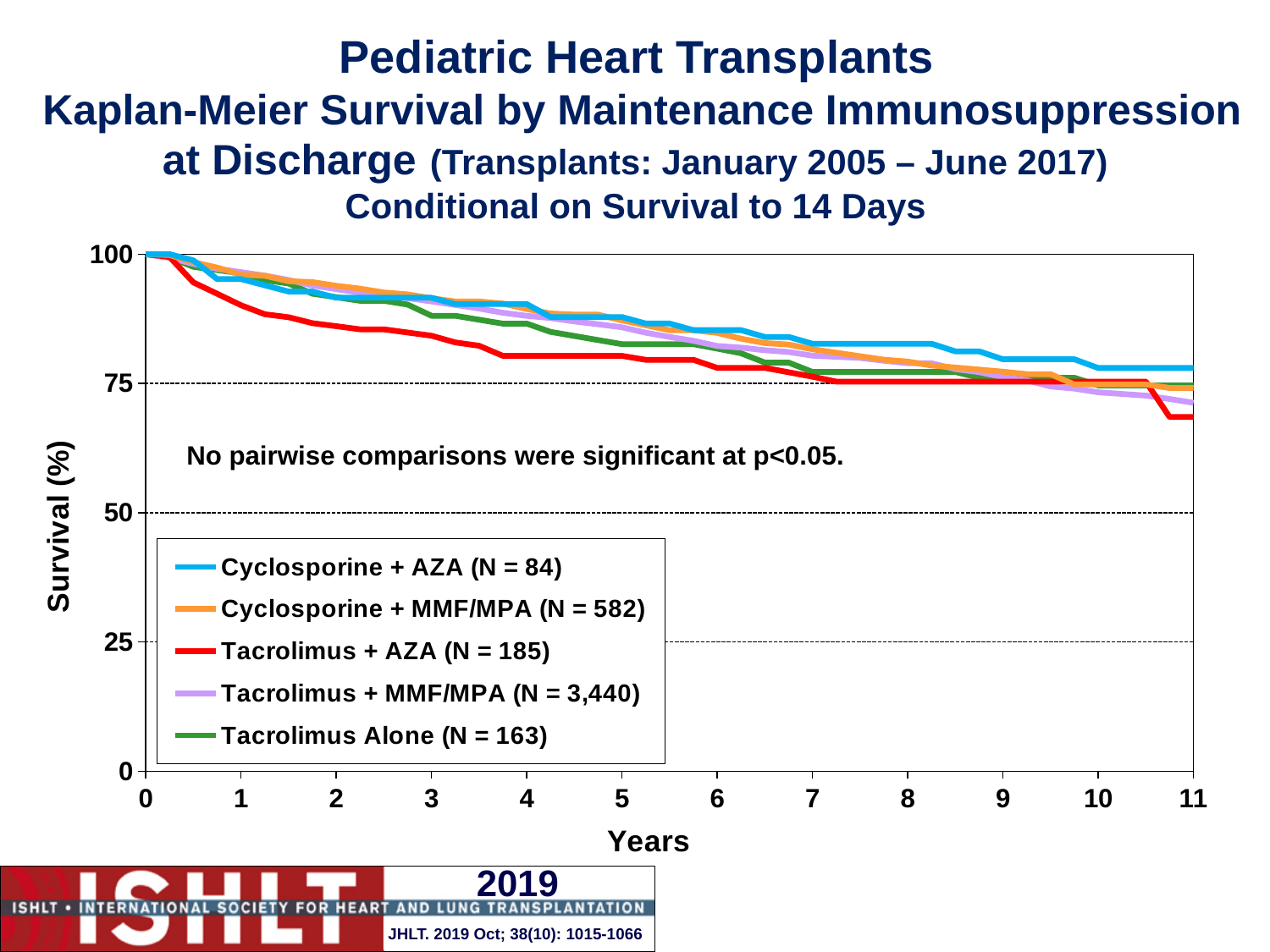
Which series has the lowest survival at 1 year? Tacrolimus + AZA At 11 years, which is higher: Cyclosporine + AZA or Tacrolimus + AZA? Cyclosporine + AZA Is the survival value for Tacrolimus + MMF/MPA at 5 years greater or less than 75? greater What is the N for the Tacrolimus + MMF/MPA series in the legend? 3,440 What is the label of the x axis? Years How many series does the legend list? 5 What kind of chart is shown on the slide? line chart Is the survival value for Tacrolimus + AZA at 1 year greater or less than 75? greater Is the survival value for Tacrolimus + AZA at 11 years greater or less than 75? less Which series has the lowest survival at 11 years? Tacrolimus + AZA Do the survival curves rise or fall as years increase? fall